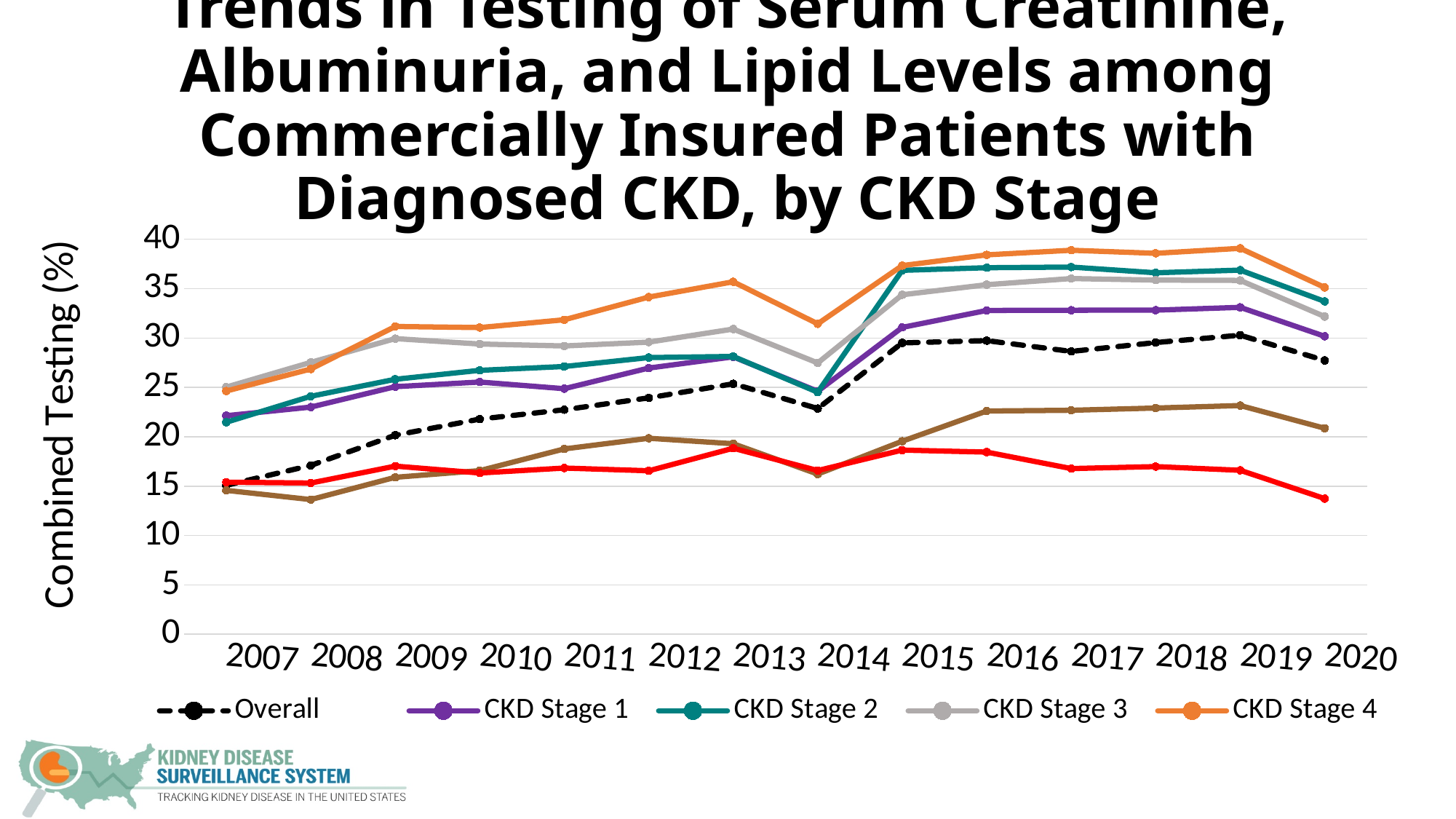
What is the label on the y axis? Combined Testing (%) Does the Overall series rise or fall from 2007 to 2013? Rise Is the value for Overall in 2014 greater or less than 25? less Which is larger in 2010: CKD Stage 1 or CKD Stage 3? CKD Stage 3 Which series has the highest value in 2019? CKD Stage 4 How many series does the legend list? 5 How many years are plotted along the x axis? 14 In which year is the Overall series at its lowest? 2007 Is the value for CKD Stage 1 in 2007 greater or less than 20? greater Is the value for CKD Stage 4 in 2019 greater or less than 35? greater What kind of chart is shown on the slide? Line chart